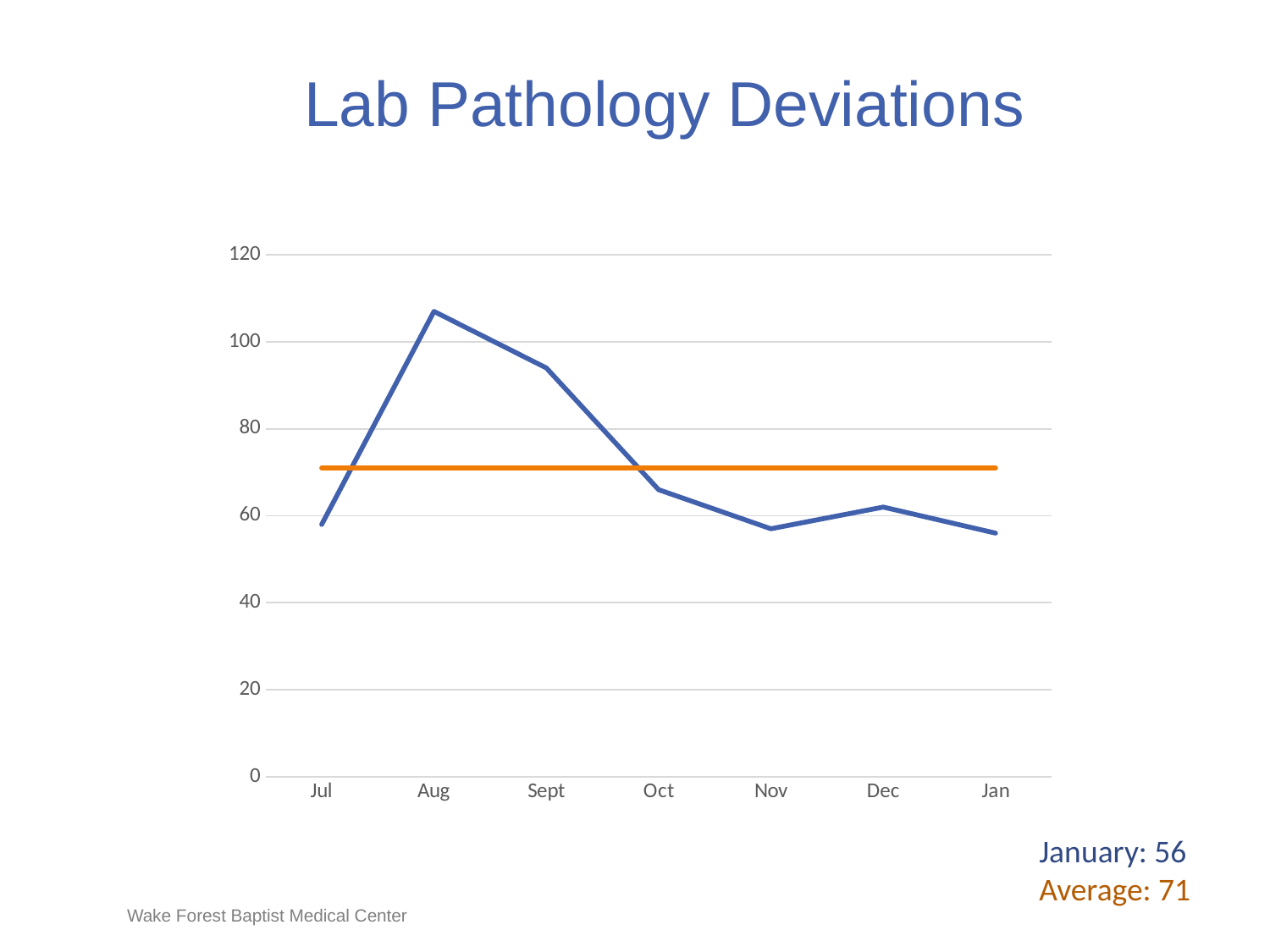
What is the difference between the average and the January value? 15 Is the value for Sept greater or less than 80? greater Do the values rise or fall from Aug to Nov? fall Which month has the highest number of deviations? Aug How many months are plotted along the x axis? 7 Which is larger, the value for Aug or the value for Sept? Aug What is the value for January, as printed on the slide? 56 What kind of chart is shown on the slide? line chart Is the value for Oct greater or less than 80? less What is the average value shown on the slide? 71 What is the title of the chart? Lab Pathology Deviations Is the value for Aug greater or less than 100? greater